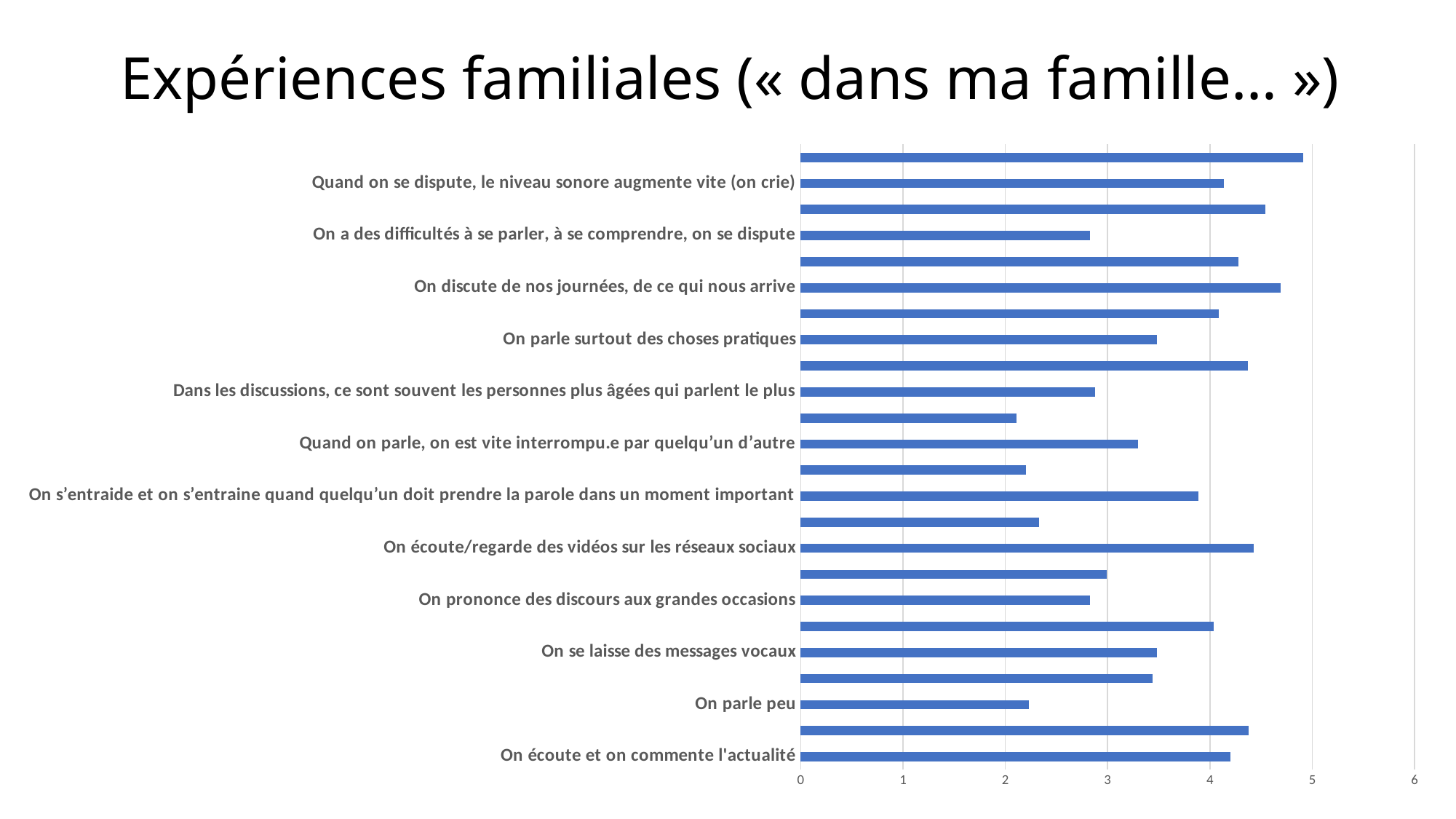
Which has the larger value: "Quand on parle, on est vite interrompu.e par quelqu'un d'autre" or "On s'entraide et on s'entraine quand quelqu'un doit prendre la parole dans un moment important"? On s'entraide et on s'entraine quand quelqu'un doit prendre la parole dans un moment important What kind of chart is shown on the slide? bar chart Is the value for "On a des difficultés à se parler, à se comprendre, on se dispute" greater or less than 3? less Is the value for "On discute de nos journées, de ce qui nous arrive" greater or less than 4? greater Is the value for "On prononce des discours aux grandes occasions" greater or less than 3? less Which has the larger value: "On discute de nos journées, de ce qui nous arrive" or "On parle surtout des choses pratiques"? On discute de nos journées, de ce qui nous arrive Which has the larger value: "On parle peu" or "On écoute et on commente l'actualité"? On écoute et on commente l'actualité What is the title of the slide? Expériences familiales (« dans ma famille… ») What is the highest value shown on the horizontal axis? 6